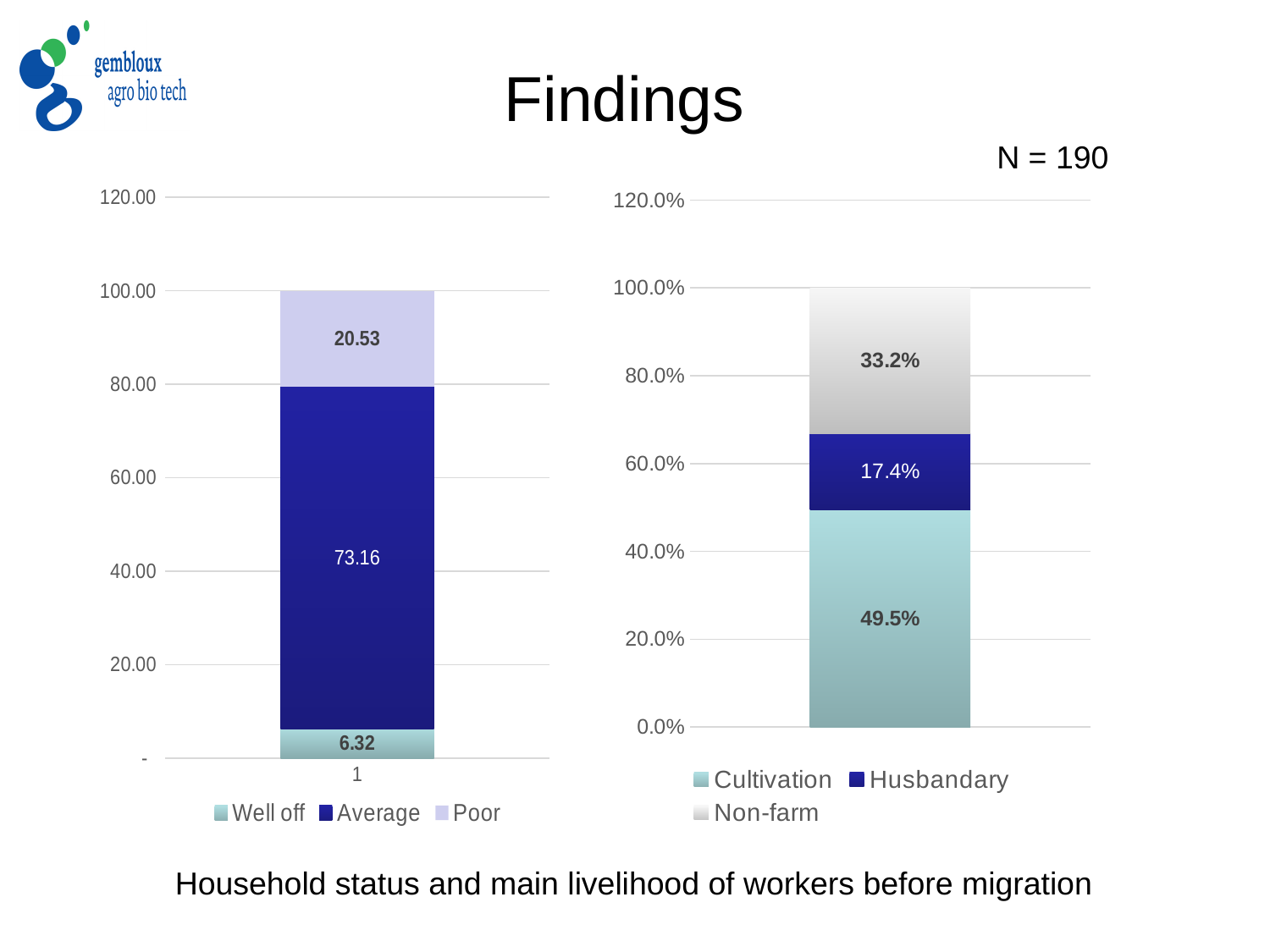
In the left chart, what is the value for Poor? 20.53 In the left chart, what is the difference between the Poor and Well off values? 14.21 In the right chart, what is the total of the stacked bar? 100.1% In the left chart, which series has the highest value? Average What kind of chart is the left chart? Stacked bar chart In the right chart, which series has the lowest value? Husbandary In the left chart, what is the value for Well off? 6.32 How many series does the legend of the right chart list? 3 In the left chart, what is the value for Average? 73.16 In the right chart, what is the value for Cultivation? 49.5% In the right chart, what is the value for Non-farm? 33.2% In the right chart, which is larger, Cultivation or Non-farm? Cultivation